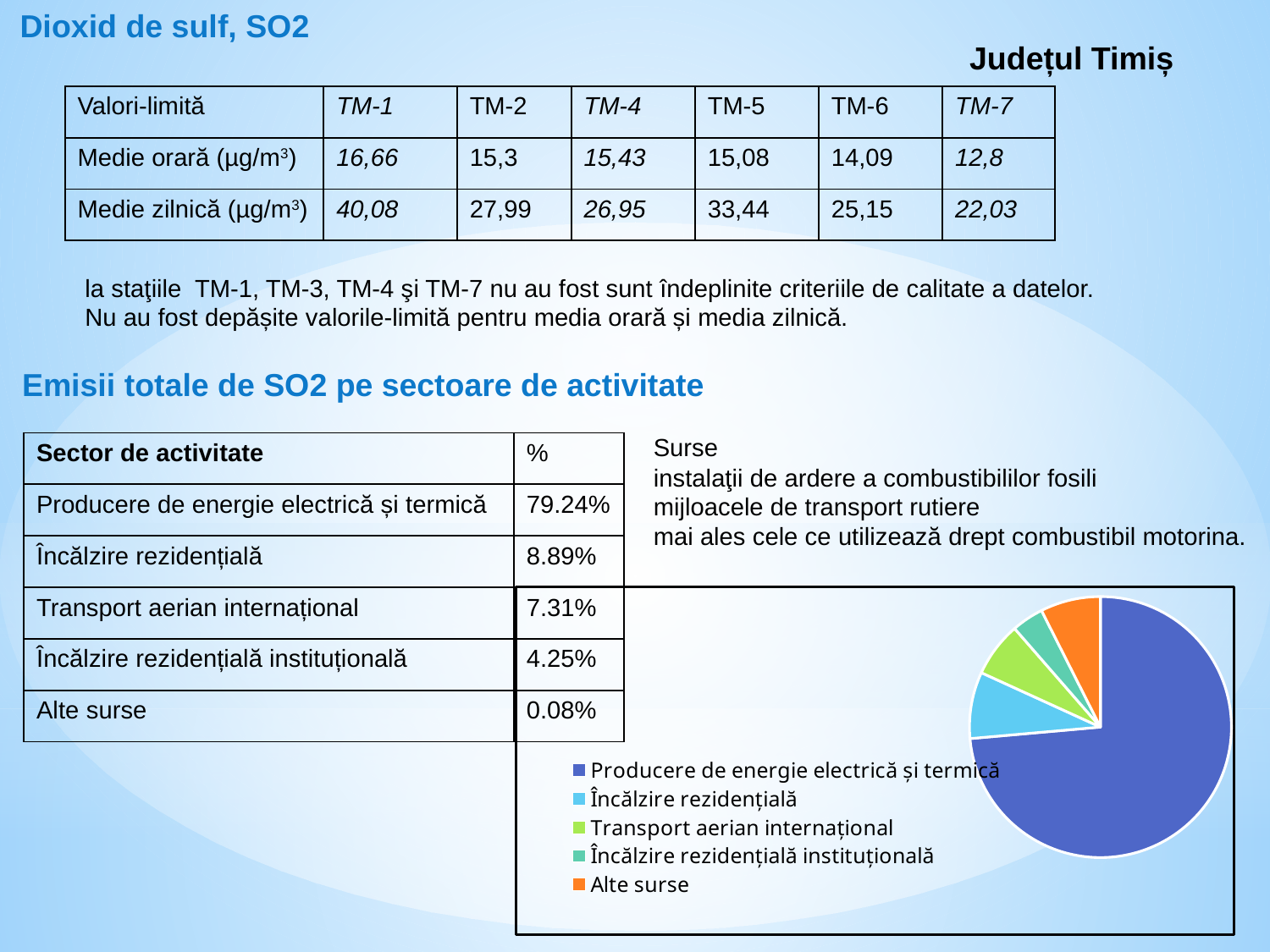
How many entries does the legend of the pie chart list? 5 What colour is the largest slice of the pie chart? blue What kind of chart is shown on the slide? pie chart In the pie chart, which is larger: Producere de energie electrică și termică or Transport aerian internațional? Producere de energie electrică și termică Is the largest slice of the pie chart more or less than half of the pie? more Which sector has the largest slice in the pie chart? Producere de energie electrică și termică In the pie chart, which is larger: Producere de energie electrică și termică or Încălzire rezidențială? Producere de energie electrică și termică How many slices does the pie chart have? 5